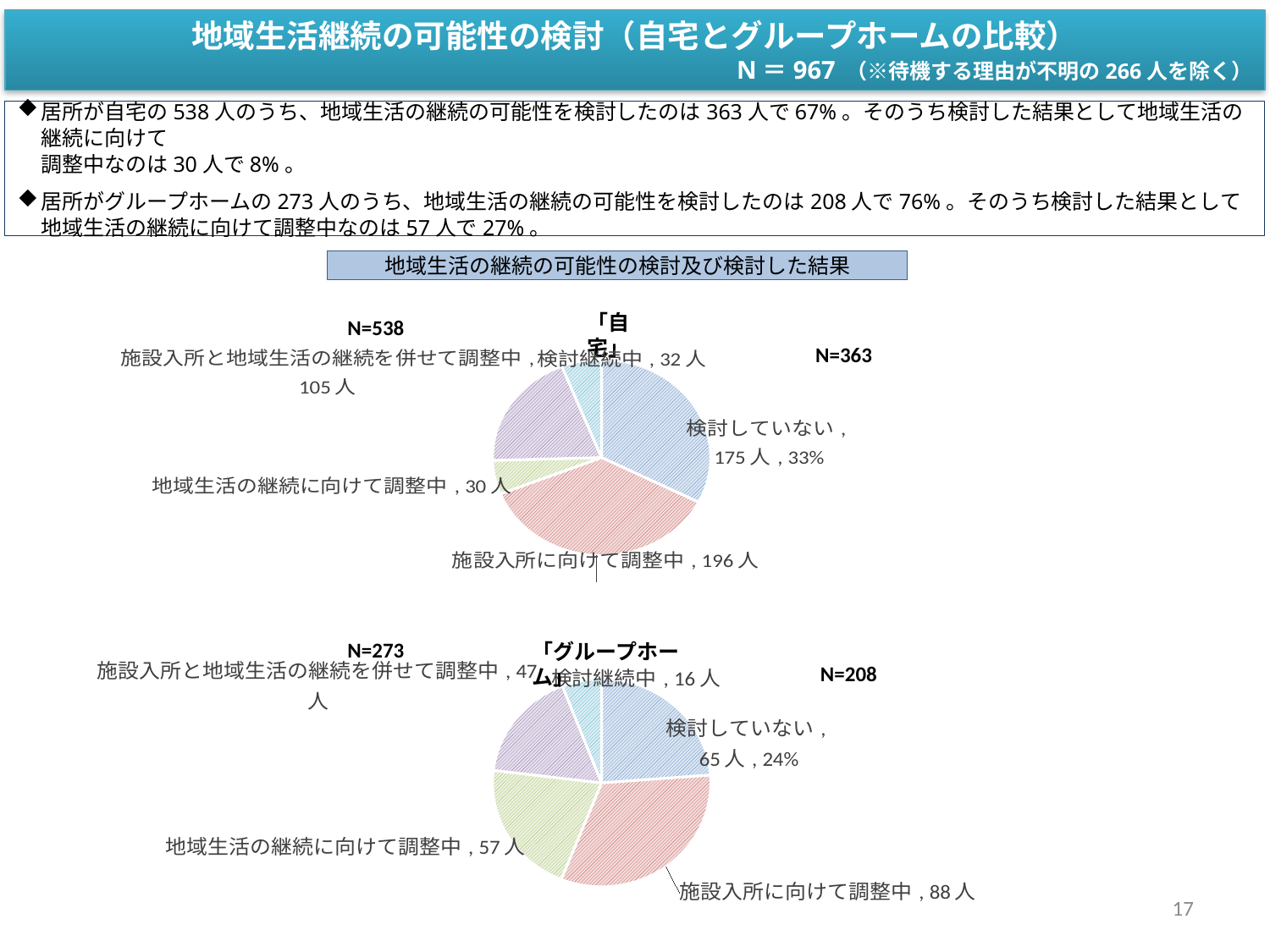
In the 「グループホーム」 pie chart (bottom), what is the difference between 検討していない and 地域生活の継続に向けて調整中? 8人 In the 「自宅」 pie chart (top), which category has the largest value? 施設入所に向けて調整中 What type of chart is used for the 「自宅」 data (top)? Pie chart In the 「グループホーム」 pie chart (bottom), which category has the smallest value? 検討継続中 In the 「グループホーム」 pie chart (bottom), which is larger: 地域生活の継続に向けて調整中 or 施設入所と地域生活の継続を併せて調整中? 地域生活の継続に向けて調整中 In the 「グループホーム」 pie chart (bottom), what percentage is shown for 検討していない? 24% In the 「自宅」 pie chart (top), what percentage is shown for 検討していない? 33% In the 「自宅」 pie chart (top), how many people are in the 検討していない category? 175人 In the 「自宅」 pie chart (top), how many slices does the pie have? 5 In the 「自宅」 pie chart (top), which category has the smallest value? 地域生活の継続に向けて調整中 In the 「自宅」 pie chart (top), what is the difference between 施設入所に向けて調整中 and 検討していない? 21人 In the 「グループホーム」 pie chart (bottom), how many people are in the 施設入所に向けて調整中 category? 88人